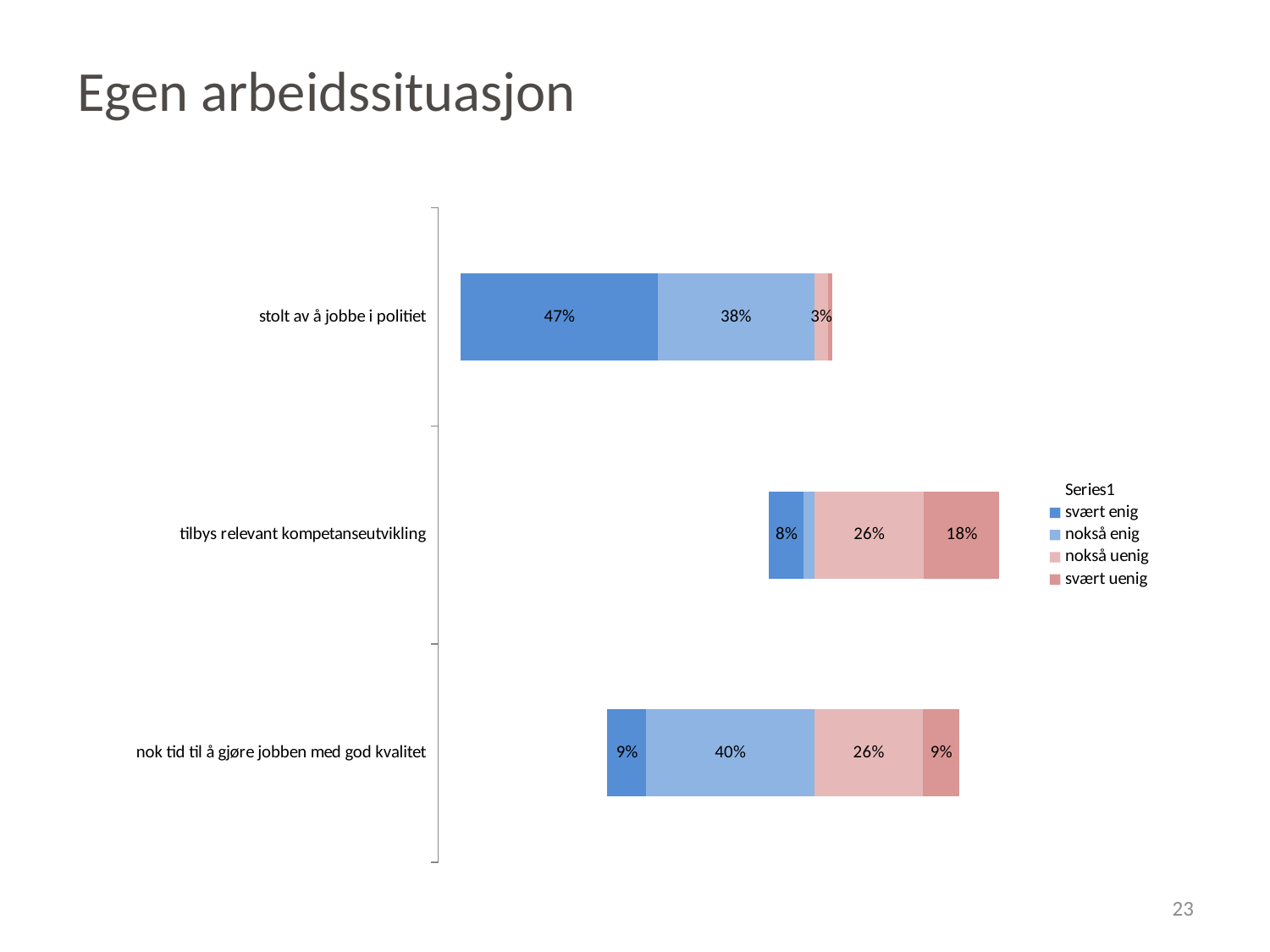
Which category has the highest 'svært enig' value? stolt av å jobbe i politiet Which is larger: the 'nokså enig' value for 'stolt av å jobbe i politiet' or for 'nok tid til å gjøre jobben med god kvalitet'? nok tid til å gjøre jobben med god kvalitet Which category has the lowest 'svært enig' value? tilbys relevant kompetanseutvikling What is the total of the labelled segments for 'nok tid til å gjøre jobben med god kvalitet'? 84% What is the difference between the 'svært enig' values for 'stolt av å jobbe i politiet' and 'nok tid til å gjøre jobben med god kvalitet'? 38 percentage points How many categories are shown on the chart? 3 What is the 'svært uenig' value for 'tilbys relevant kompetanseutvikling'? 18% What kind of chart is shown on the slide? Stacked bar chart What is the 'nokså uenig' value for 'tilbys relevant kompetanseutvikling'? 26% What is the 'nokså enig' value for 'nok tid til å gjøre jobben med god kvalitet'? 40% What is the title of the slide? Egen arbeidssituasjon What is the 'svært enig' value for 'stolt av å jobbe i politiet'? 47%